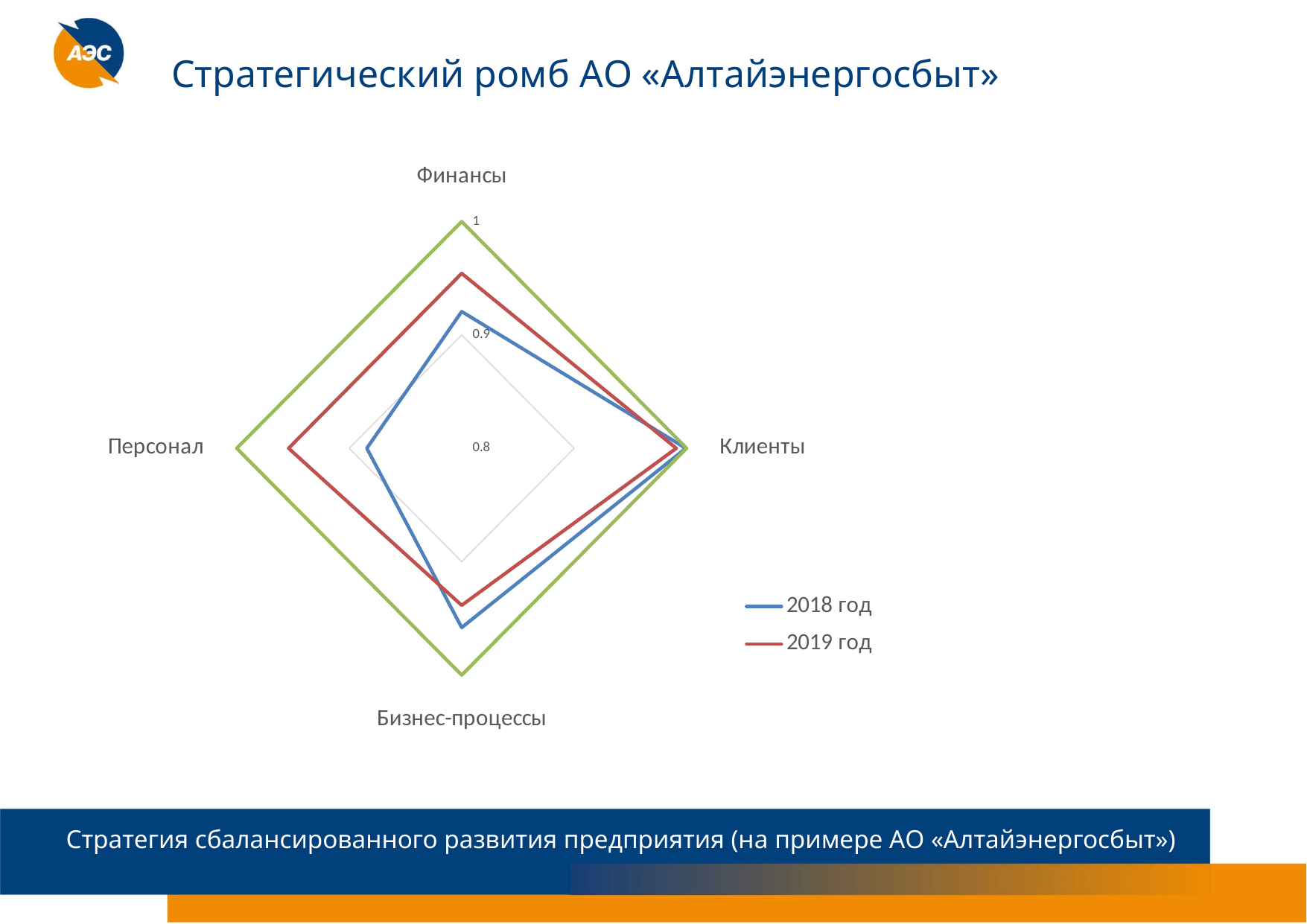
Is the value for Финансы in 2018 год greater or less than 0.9? greater Which category has the highest value for 2019 год? Клиенты Is the value for Персонал in 2019 год greater or less than 0.9? greater What is the title of the slide containing the chart? Стратегический ромб АО «Алтайэнергосбыт» Which year has the larger value for Персонал, 2018 год or 2019 год? 2019 год Which category has the lowest value for 2018 год? Персонал Which series are listed in the legend? 2018 год and 2019 год Is the value for Персонал in 2018 год greater or less than 0.9? less How many series does the legend list? 2 How many categories (axes) does the radar chart have? 4 What kind of chart is shown on the slide? Radar chart Which year has the larger value for Финансы, 2018 год or 2019 год? 2019 год